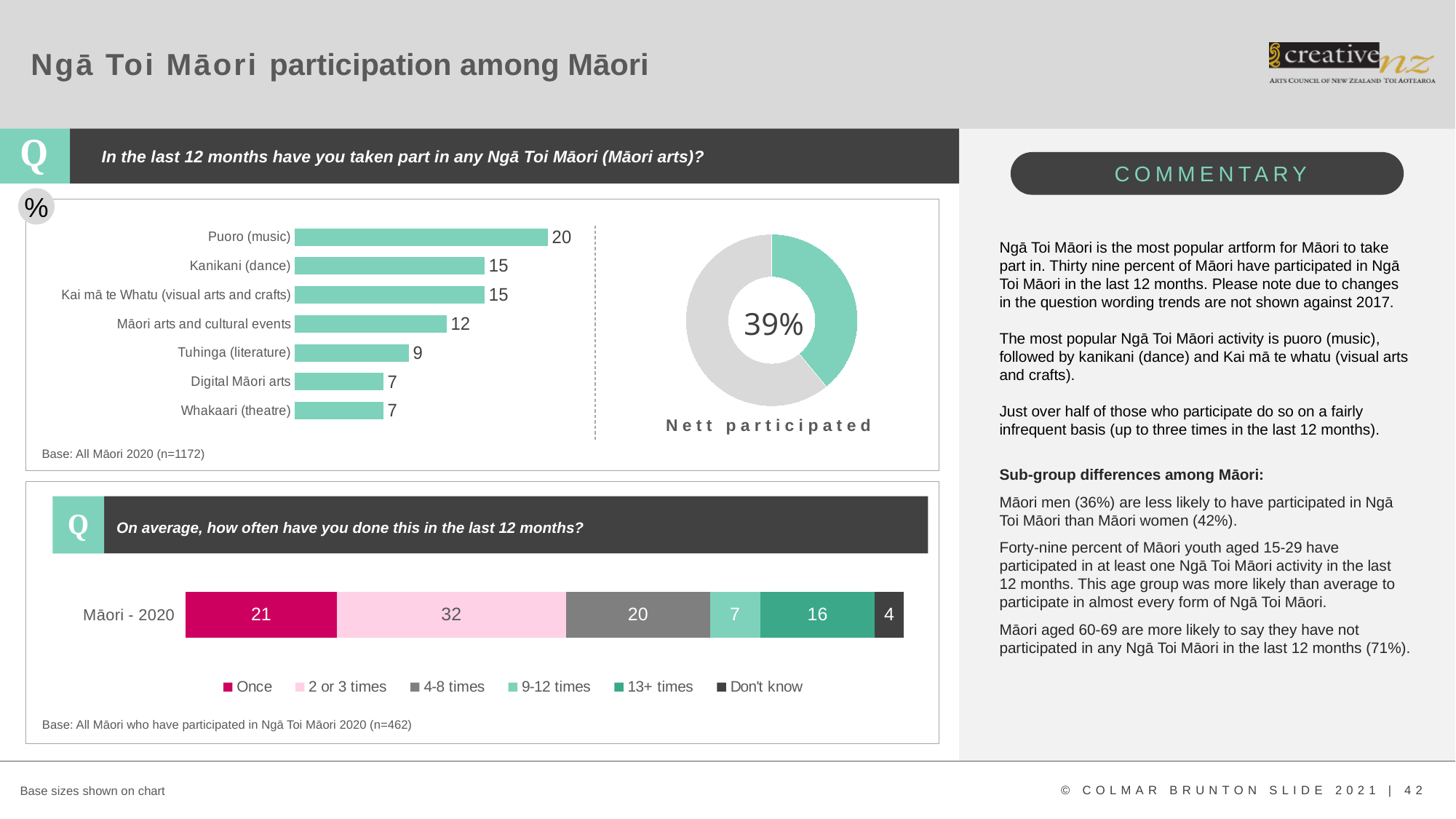
In the top-left bar chart of participation by activity, which is larger: Kanikani (dance) or Digital Māori arts? Kanikani (dance) In the bottom stacked bar chart on frequency of participation, what is the value for '13+ times'? 16 In the top-left bar chart of participation by activity, what is the value for Puoro (music)? 20 In the 'Nett participated' donut chart, what percentage is shown in the centre? 39% What kind of chart is the top-left chart showing participation by activity? Bar chart How many activities are listed in the top-left bar chart of participation by activity? 7 In the top-left bar chart of participation by activity, which activity has the highest value? Puoro (music) In the top-left bar chart of participation by activity, what is the value for Tuhinga (literature)? 9 In the bottom stacked bar chart on frequency of participation, what is the total of the Māori - 2020 bar? 100 How many series does the legend of the bottom stacked bar chart list? 6 In the top-left bar chart of participation by activity, what is the difference between Puoro (music) and Māori arts and cultural events? 8 In the bottom stacked bar chart on frequency of participation, what is the value for '2 or 3 times'? 32